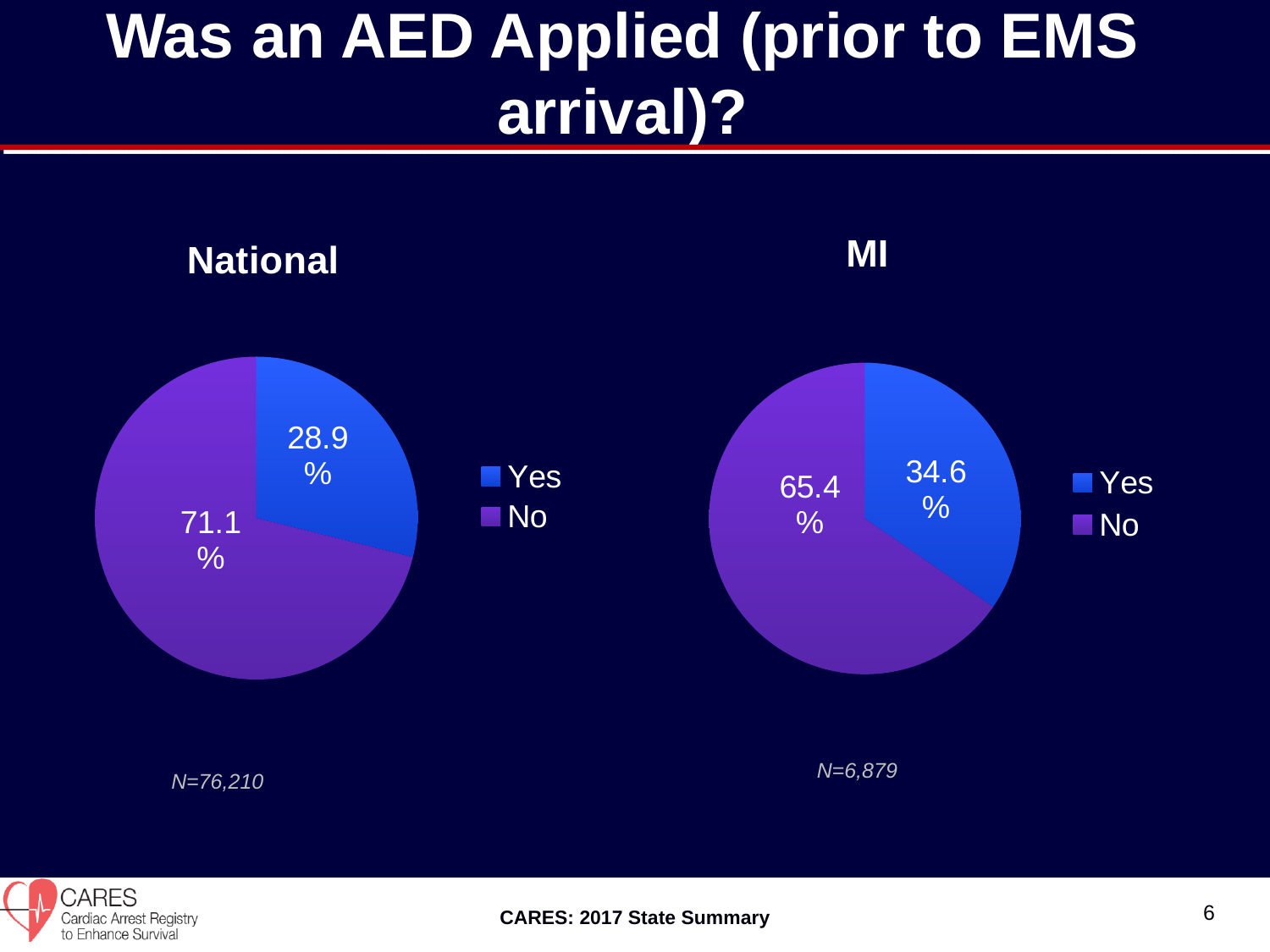
What is the difference between the No and Yes percentages in the National pie chart? 42.2% In the National pie chart, which slice is the largest? No In the MI pie chart, what percentage is shown for Yes? 34.6% How many slices does the MI pie chart have? 2 Which is larger: the Yes percentage in the National chart or the Yes percentage in the MI chart? MI In the MI pie chart, what percentage is shown for No? 65.4% In the National pie chart, what percentage is shown for No? 71.1% In the National pie chart, what percentage is shown for Yes? 28.9% In the MI pie chart, which slice is the smallest? Yes What type of chart is used for the National data? Pie chart What is the difference between the No and Yes percentages in the MI pie chart? 30.8% What sample size (N) is shown below the MI pie chart? N=6,879